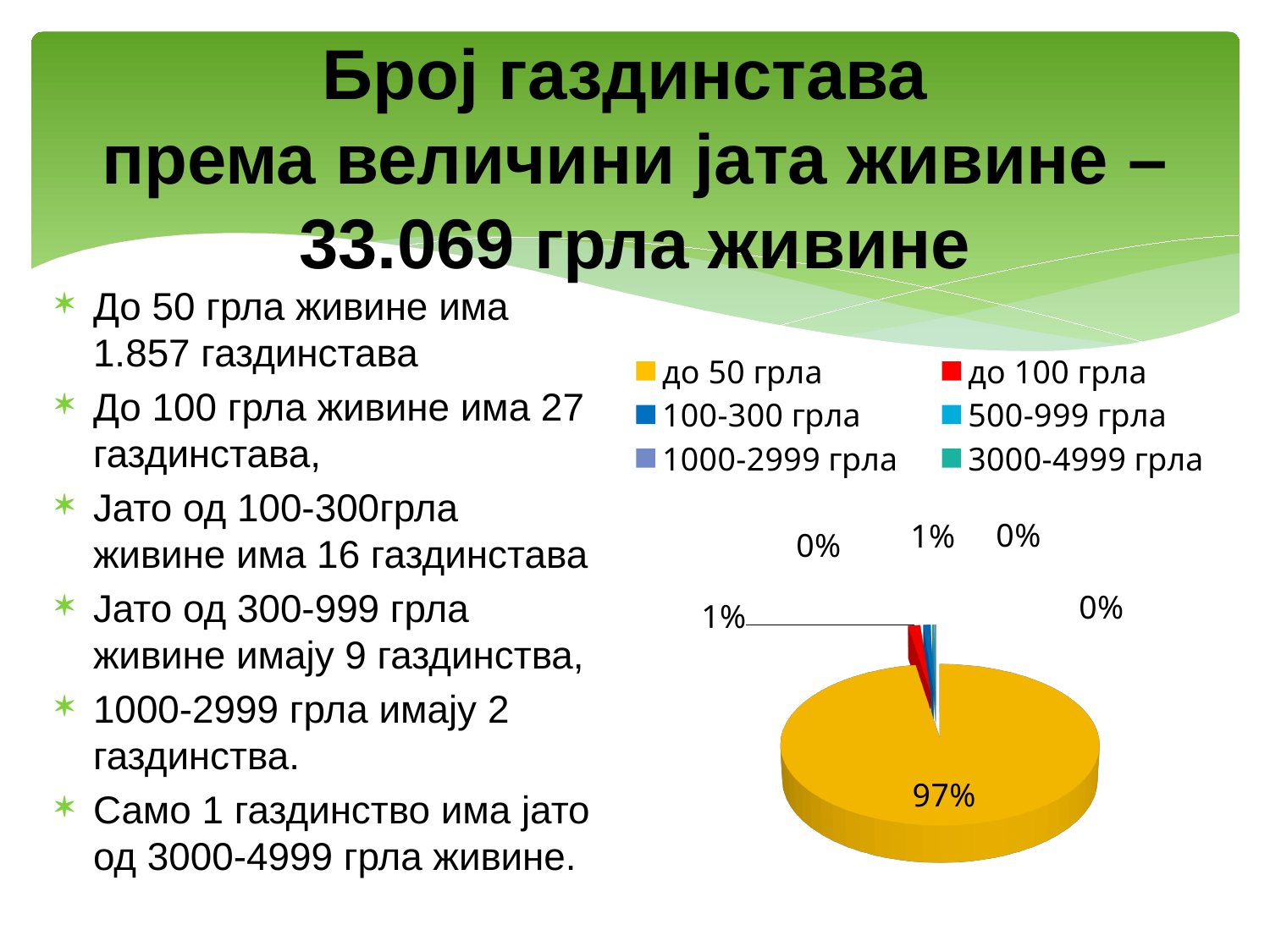
Which category has the largest slice of the pie? до 50 грла How many slices does the pie chart have? 6 How many entries does the chart legend list? 6 What is the difference between the percentage for "до 50 грла" and the percentage for "до 100 грла"? 96% What colour does the legend assign to "до 100 грла"? red Which is larger, the slice for "до 50 грла" or the slice for "до 100 грла"? до 50 грла What percentage is labelled for the "до 100 грла" slice? 1% What share of the pie does the "до 50 грла" slice take? 97% How many slices in the pie chart are labelled 0%? 3 What percentage is shown for the "до 50 грла" category? 97% What colour is the "до 50 грла" slice in the pie chart? yellow What kind of chart is shown on the slide? pie chart